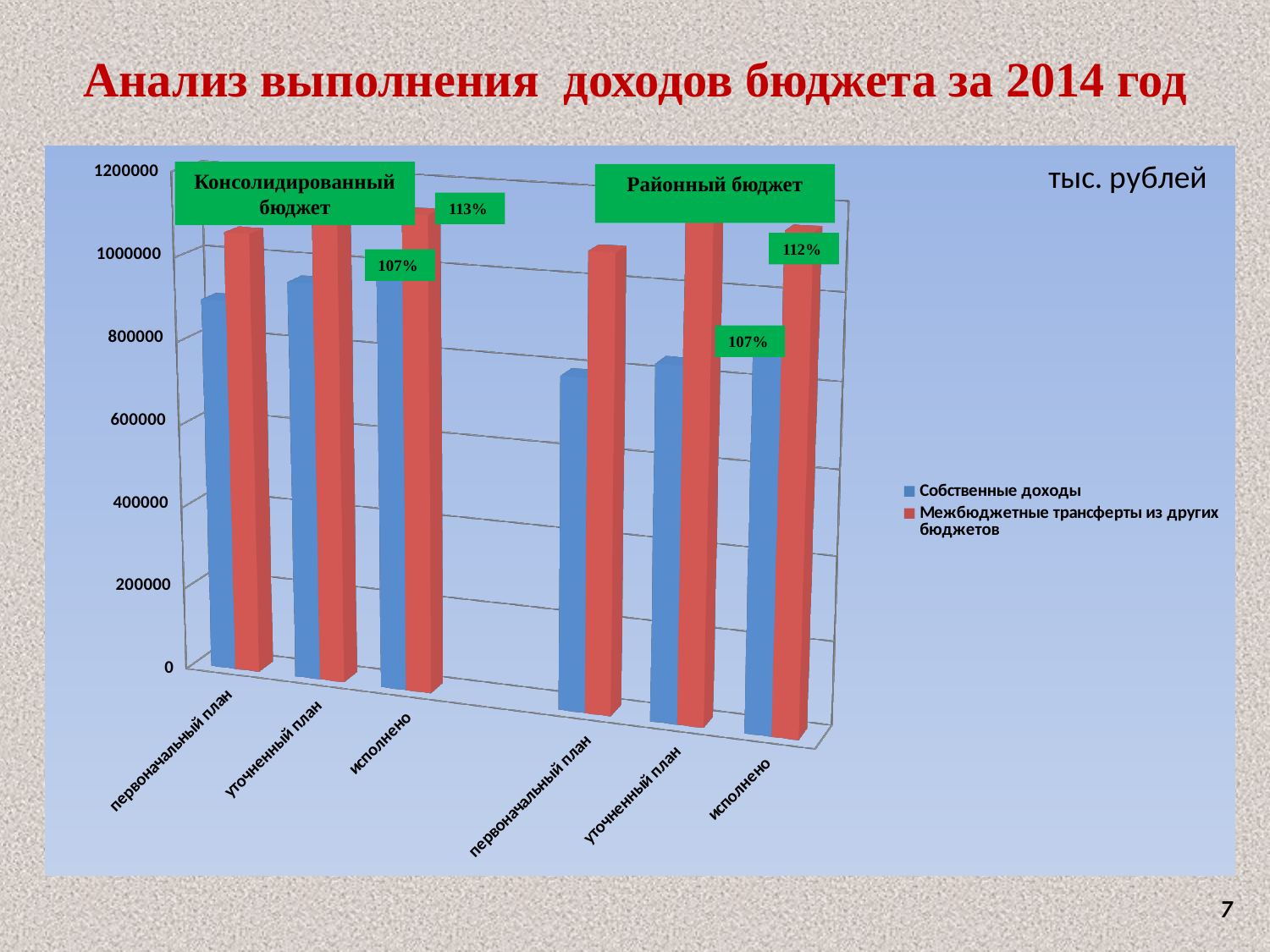
How many series does the legend list? 2 In the Консолидированный бюджет group, is the Собственные доходы value for первоначальный план greater or less than 1000000? less What percentage label is shown next to the Межбюджетные трансферты bar for исполнено in the Районный бюджет group? 112% In the Консолидированный бюджет group, which is larger for первоначальный план: Собственные доходы or Межбюджетные трансферты из других бюджетов? Межбюджетные трансферты из других бюджетов How many categories are shown on the x axis in total? 6 What are the two budget groups labelled in the green boxes above the bars? Консолидированный бюджет; Районный бюджет In the Консолидированный бюджет group, is the Межбюджетные трансферты value for исполнено greater or less than 1000000? greater What percentage label is shown next to the Собственные доходы bar for исполнено in the Районный бюджет group? 107% What percentage label is shown next to the Межбюджетные трансферты bar for исполнено in the Консолидированный бюджет group? 113% What are the two series named in the legend? Собственные доходы; Межбюджетные трансферты из других бюджетов What kind of chart is shown on the slide? bar chart What percentage label is shown next to the Собственные доходы bar for исполнено in the Консолидированный бюджет group? 107%